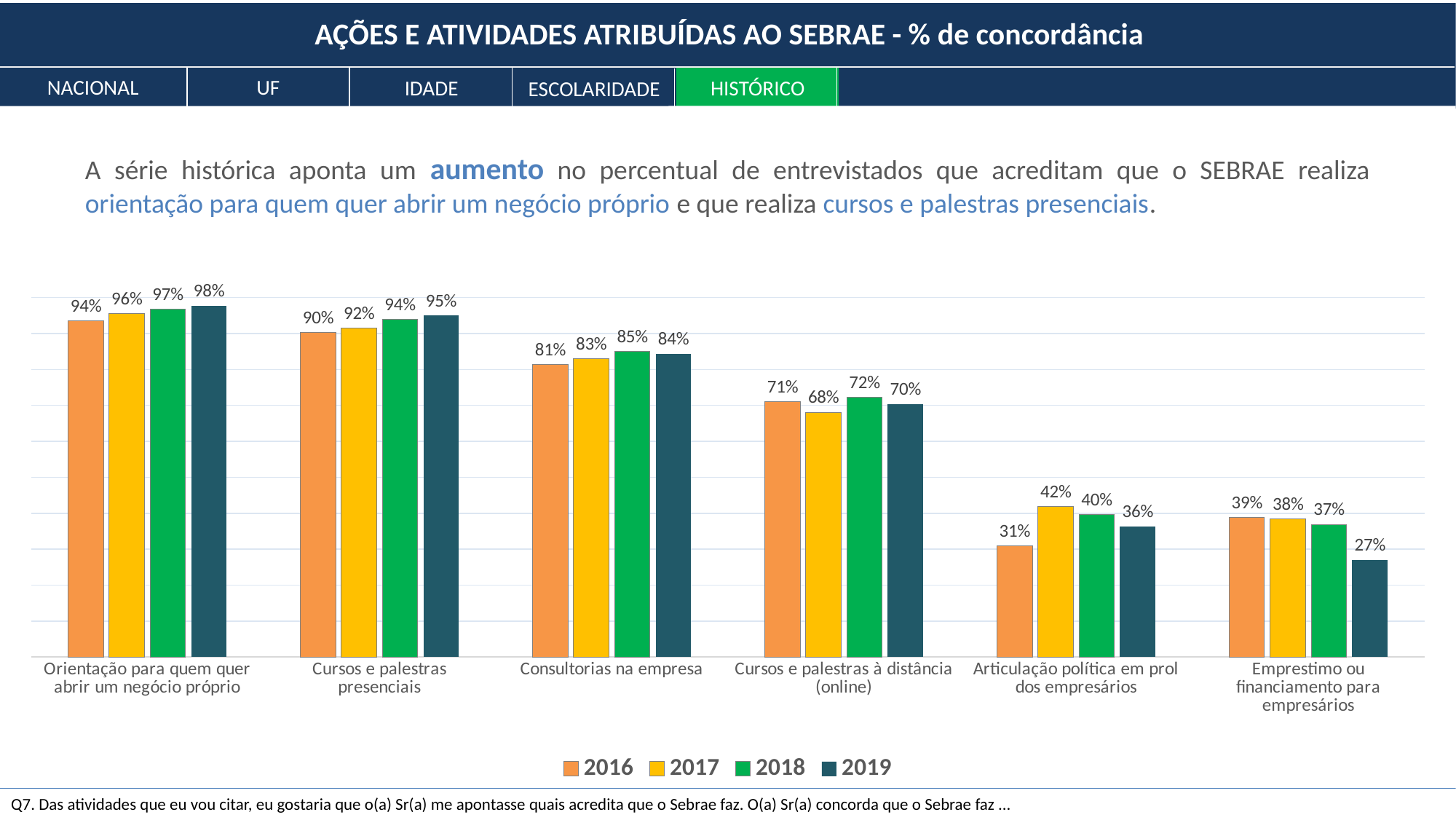
Do the values for "Cursos e palestras presenciais" rise or fall from 2016 to 2019? Rise What is the 2016 value for "Articulação política em prol dos empresários"? 31% Which category has the highest 2018 value? Orientação para quem quer abrir um negócio próprio What is the difference between the 2019 and 2016 values for "Emprestimo ou financiamento para empresários"? 12% Which series is shown in orange in the legend? 2016 What is the 2017 value for "Cursos e palestras à distância (online)"? 68% How many series does the legend list? 4 What kind of chart is shown on the slide? Bar chart Which category has the lowest 2019 value? Emprestimo ou financiamento para empresários What is the 2019 value for "Orientação para quem quer abrir um negócio próprio"? 98% Which is larger for "Consultorias na empresa": the 2018 value or the 2019 value? 2018 How many categories are shown on the x axis? 6